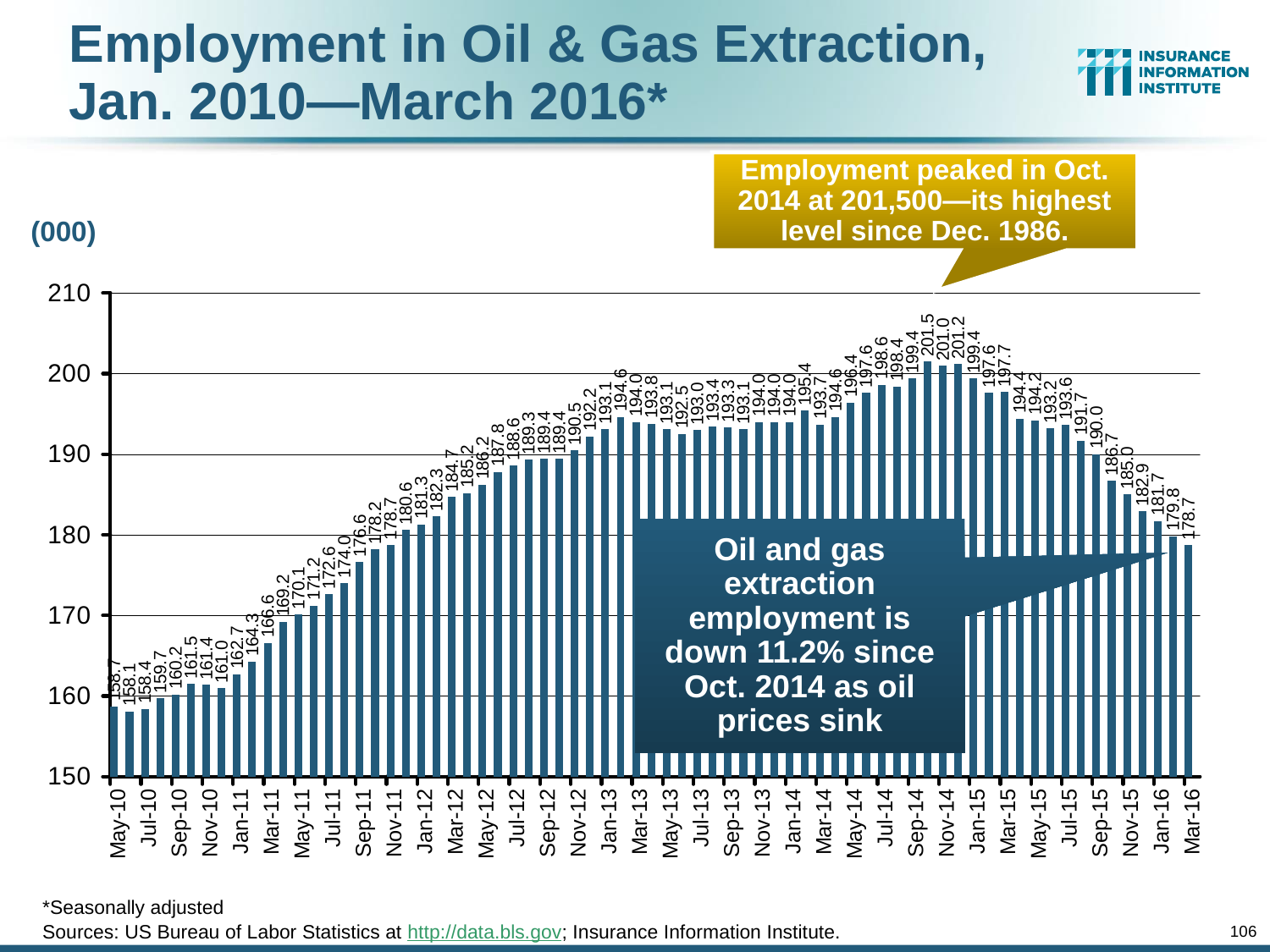
What is the employment value for Mar-16? 178.7 What unit label is shown above the y-axis? (000) What type of chart is shown on the slide? bar chart What is the highest employment value shown on the chart? 201.5 Is the value for Sep-11 greater or less than 180? less What is the lowest employment value shown on the chart? 158.1 What is the employment value for Jan-13? 193.1 What is the employment value for Oct-14? 201.5 Which is larger, the value for Jan-13 or the value for Jan-15? Jan-15 What is the difference between the Oct-14 value and the Mar-16 value? 22.8 What is the employment value for May-10? 158.7 Do the values generally rise or fall from May-10 to Oct-14? rise